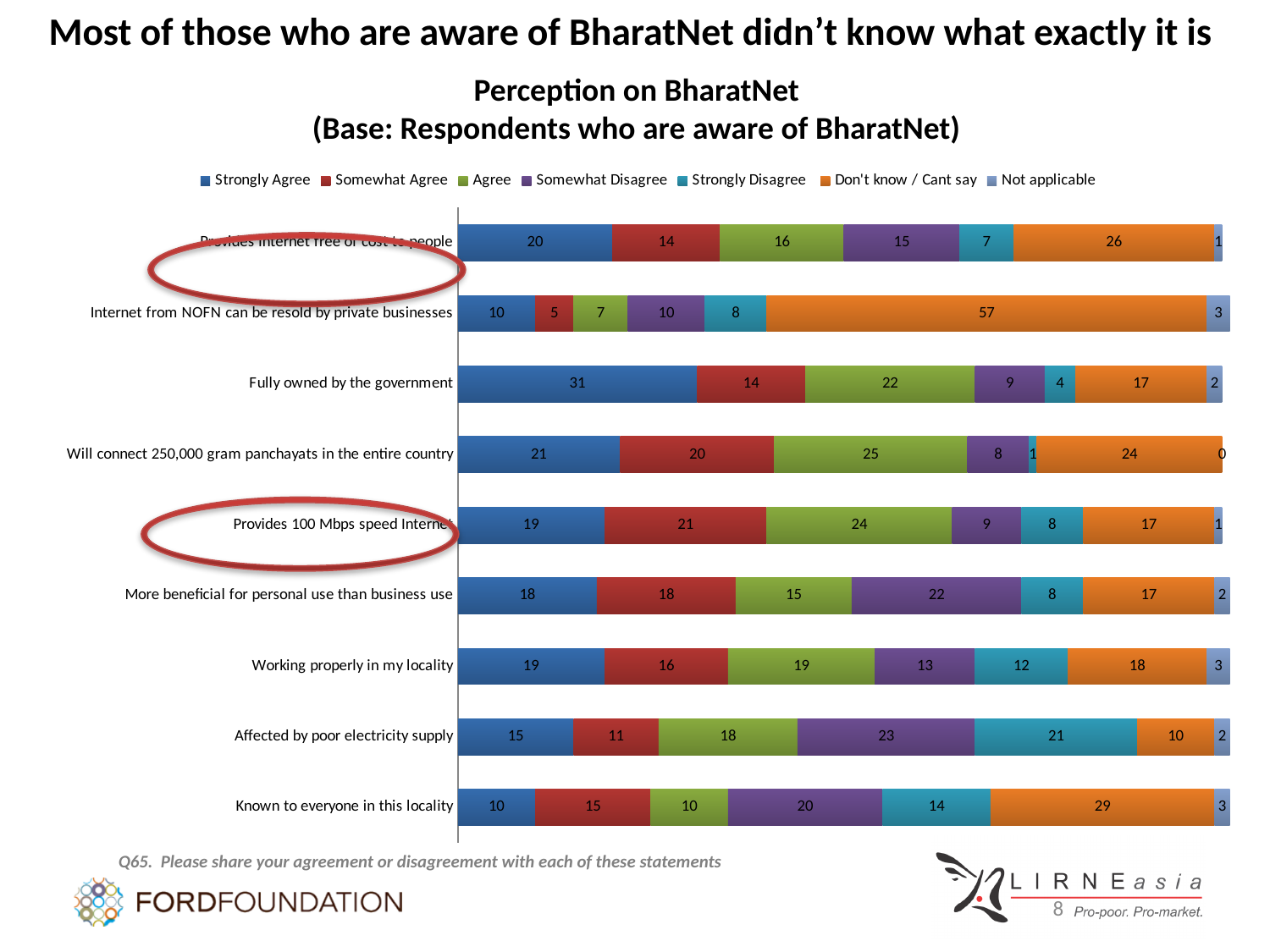
What is the total of the stacked bar for 'Working properly in my locality'? 100 What is the Somewhat Disagree value for 'Affected by poor electricity supply'? 23 What is the difference between the Don't know / Cant say values for 'Internet from NOFN can be resold by private businesses' and 'Known to everyone in this locality'? 28 What is the Don't know / Cant say value for 'Internet from NOFN can be resold by private businesses'? 57 How many statements (categories) are plotted on the chart? 9 What is the Strongly Agree value for 'Fully owned by the government'? 31 Which statement has the lowest Don't know / Cant say value? Affected by poor electricity supply What is the title of the chart? Perception on BharatNet (Base: Respondents who are aware of BharatNet) Which statement has the highest Strongly Agree value? Fully owned by the government How many series does the legend list? 7 What kind of chart is shown on the slide? Stacked bar chart Which is larger: the Agree value for 'Will connect 250,000 gram panchayats in the entire country' or the Agree value for 'Provides 100 Mbps speed Internet'? Will connect 250,000 gram panchayats in the entire country